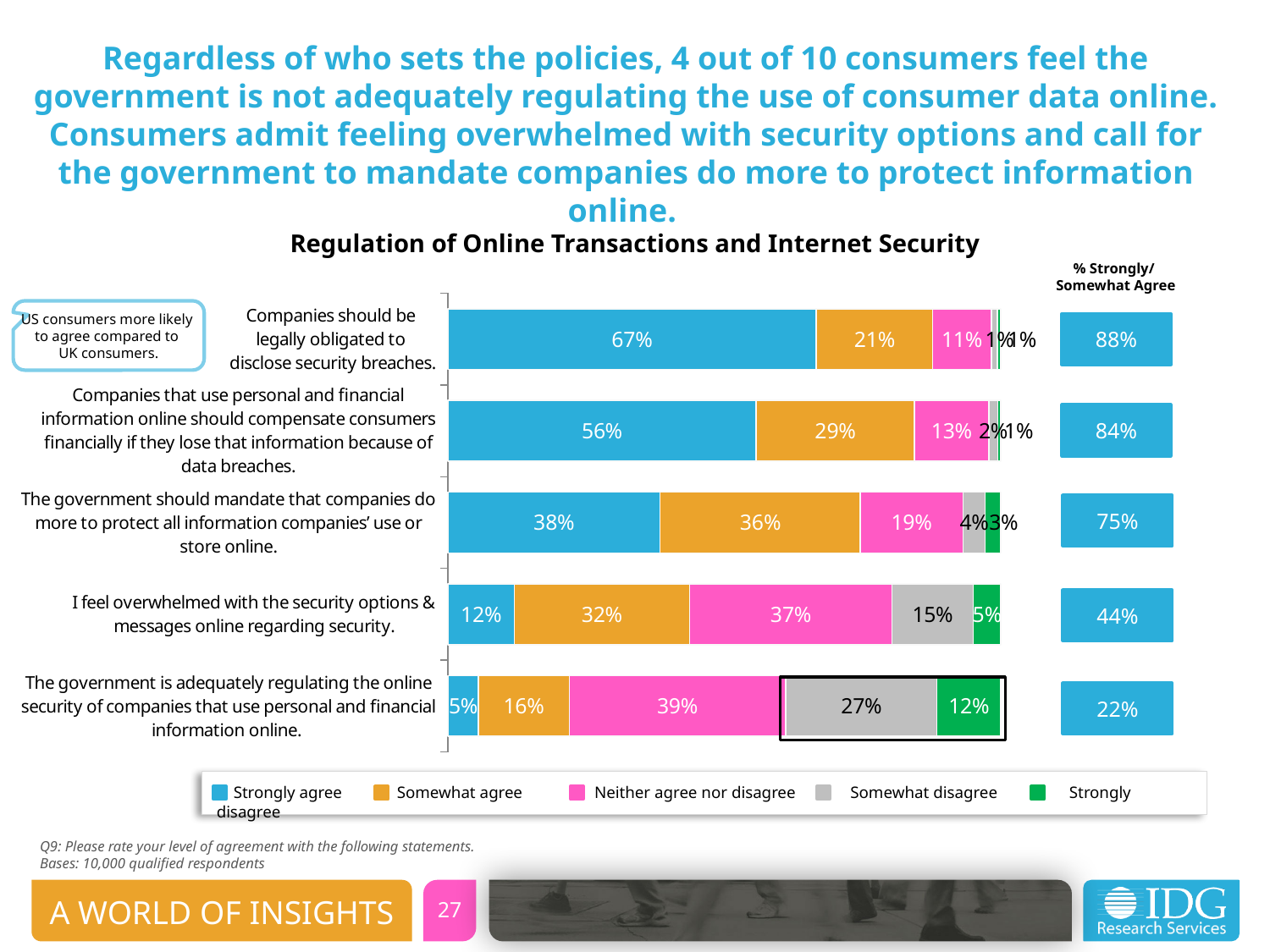
How many series does the legend list? 5 How many percentage points higher is the strongly agree share for 'Companies should be legally obligated to disclose security breaches' than for 'Companies that use personal and financial information online should compensate consumers financially if they lose that information because of data breaches'? 11 percentage points How many statements are shown in the chart? 5 What is the % Strongly/Somewhat Agree value for the statement that the government should mandate that companies do more to protect all information companies' use or store online? 75% What percentage of consumers strongly agree that companies should be legally obligated to disclose security breaches? 67% What kind of chart is used to show the regulation of online transactions and internet security data? Stacked bar chart Which statement has the lowest share of consumers who strongly agree? The government is adequately regulating the online security of companies that use personal and financial information online. Which statement has the highest share of consumers who strongly agree? Companies should be legally obligated to disclose security breaches. What percentage of consumers strongly disagree that the government is adequately regulating the online security of companies that use personal and financial information online? 12% What is the combined strongly agree and somewhat agree share for 'I feel overwhelmed with the security options & messages online regarding security'? 44% Which statement has a larger somewhat agree share: the government should mandate that companies do more to protect information, or companies should compensate consumers financially for data breaches? The government should mandate that companies do more to protect all information companies' use or store online. What percentage of consumers neither agree nor disagree with the statement 'I feel overwhelmed with the security options & messages online regarding security'? 37%